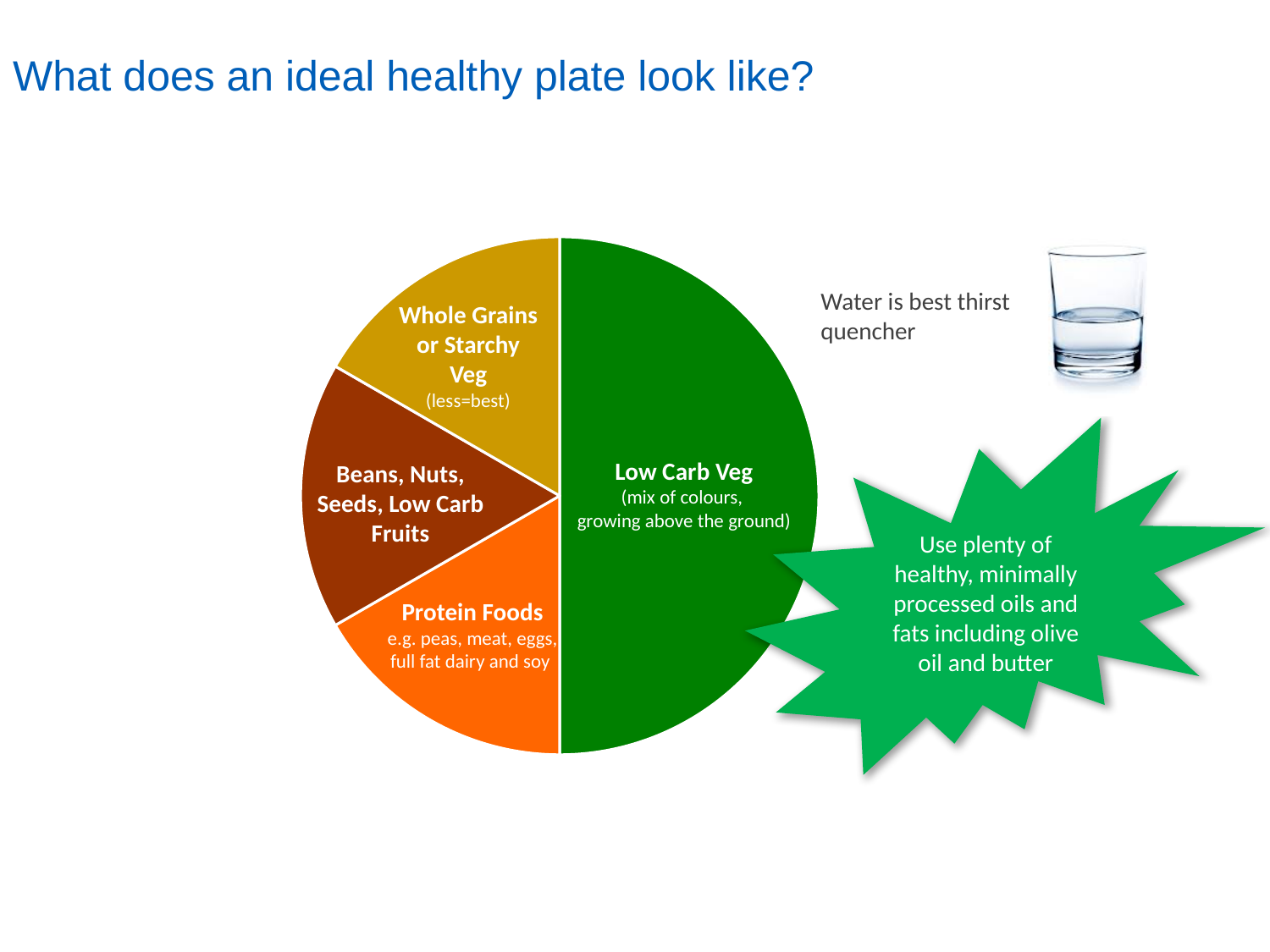
What kind of chart is shown on the slide? pie chart What is the title of the slide containing the pie chart? What does an ideal healthy plate look like? How many slices does the pie chart have? 4 What colour is the Low Carb Veg slice of the pie chart? green Which slice is larger, Low Carb Veg or Beans, Nuts, Seeds, Low Carb Fruits? Low Carb Veg Which slice of the pie chart is the largest? Low Carb Veg Which slice is larger, Low Carb Veg or Protein Foods? Low Carb Veg Which slice is larger, Low Carb Veg or Whole Grains or Starchy Veg? Low Carb Veg